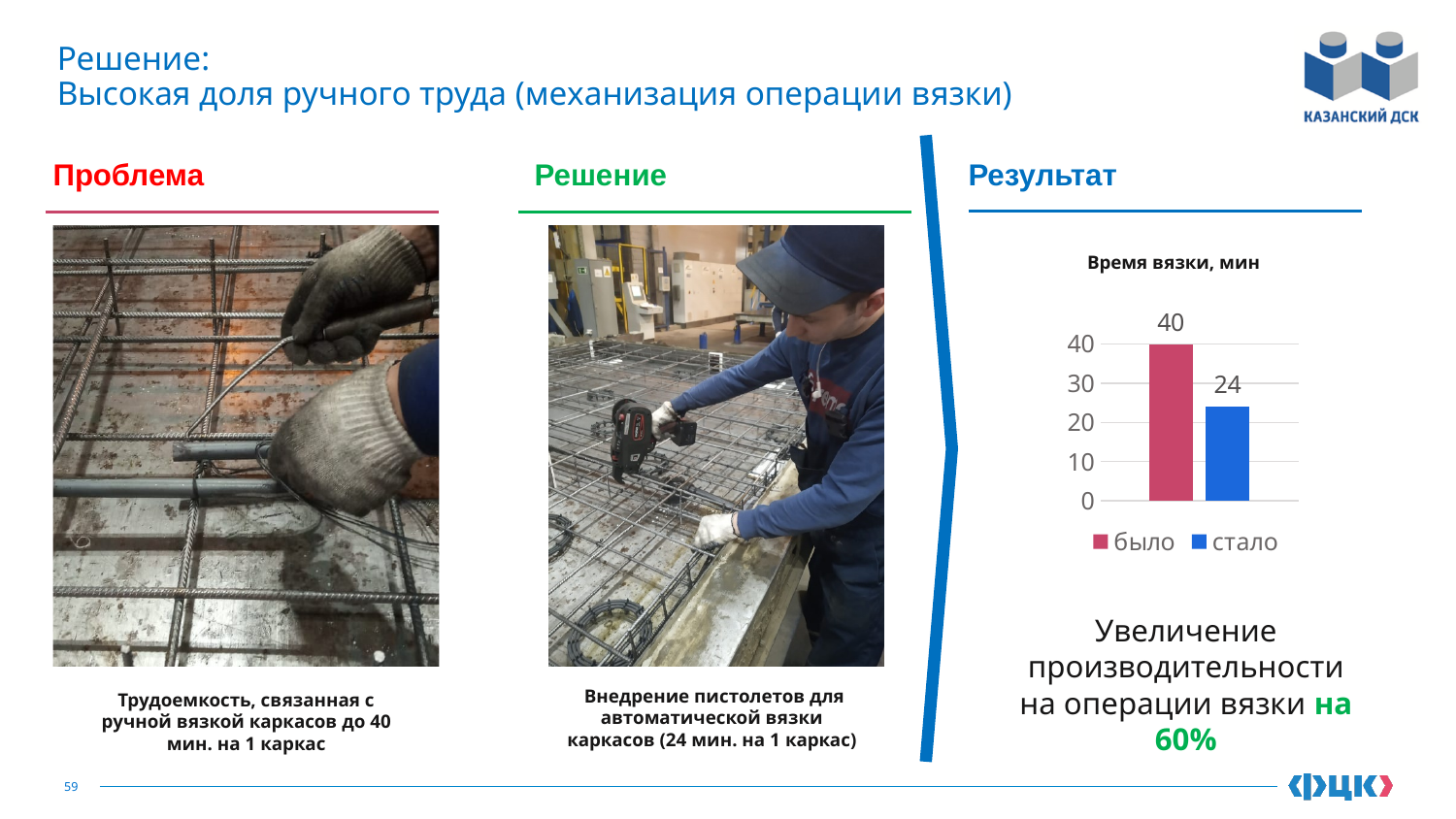
Is the value for 'стало' in the chart 'Время вязки, мин' greater or less than 30? less What kind of chart is 'Время вязки, мин'? bar chart What colour is the 'было' bar in the chart 'Время вязки, мин'? red (crimson) Which series has the highest value in the chart 'Время вязки, мин'? было What is the title of the chart on the slide? Время вязки, мин How many series does the legend of the chart 'Время вязки, мин' list? 2 How many bars are plotted in the chart 'Время вязки, мин'? 2 What is the difference between the 'было' and 'стало' values in the chart 'Время вязки, мин'? 16 What is the value for 'было' in the chart 'Время вязки, мин'? 40 Which series has the lowest value in the chart 'Время вязки, мин'? стало In the chart 'Время вязки, мин', which is larger: 'было' or 'стало'? было What is the value for 'стало' in the chart 'Время вязки, мин'? 24